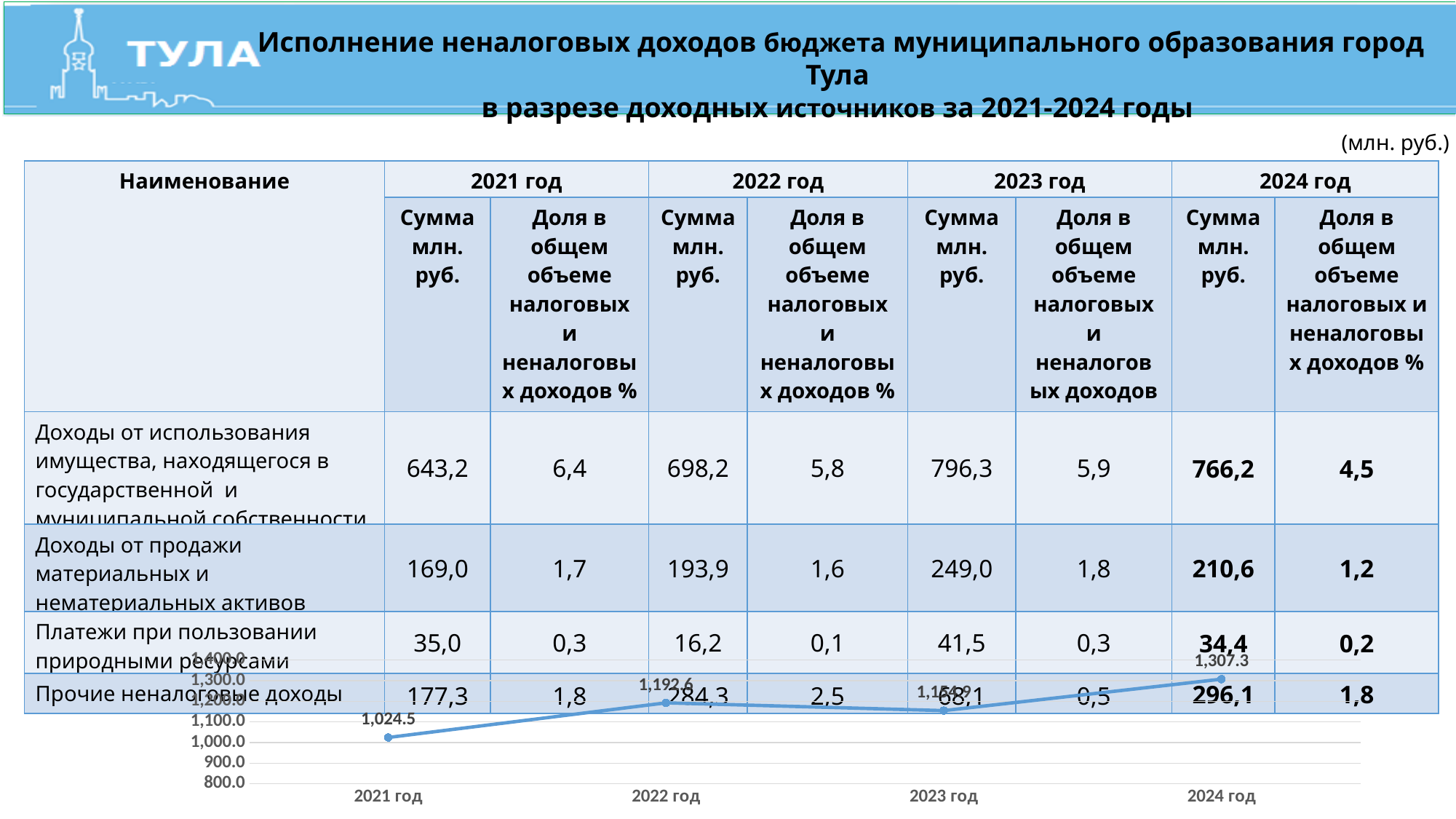
How many data points are plotted on the line chart? 4 On the line chart, which is larger: the value for 2022 год or the value for 2023 год? 2022 год Which year has the highest value on the line chart? 2024 год What is the value plotted for 2022 год on the line chart? 1,192.6 What is the value plotted for 2024 год on the line chart? 1,307.3 On the line chart, what is the difference between the 2024 год value and the 2021 год value? 282.8 Which year has the lowest value on the line chart? 2021 год On the line chart, is the value for 2023 год greater or less than 1,100? greater What kind of chart is shown at the bottom of the slide? line chart On the line chart, what is the difference between the 2022 год value and the 2021 год value? 168.1 On the line chart, does the value rise or fall from 2022 год to 2023 год? fall What is the value plotted for 2021 год on the line chart? 1,024.5